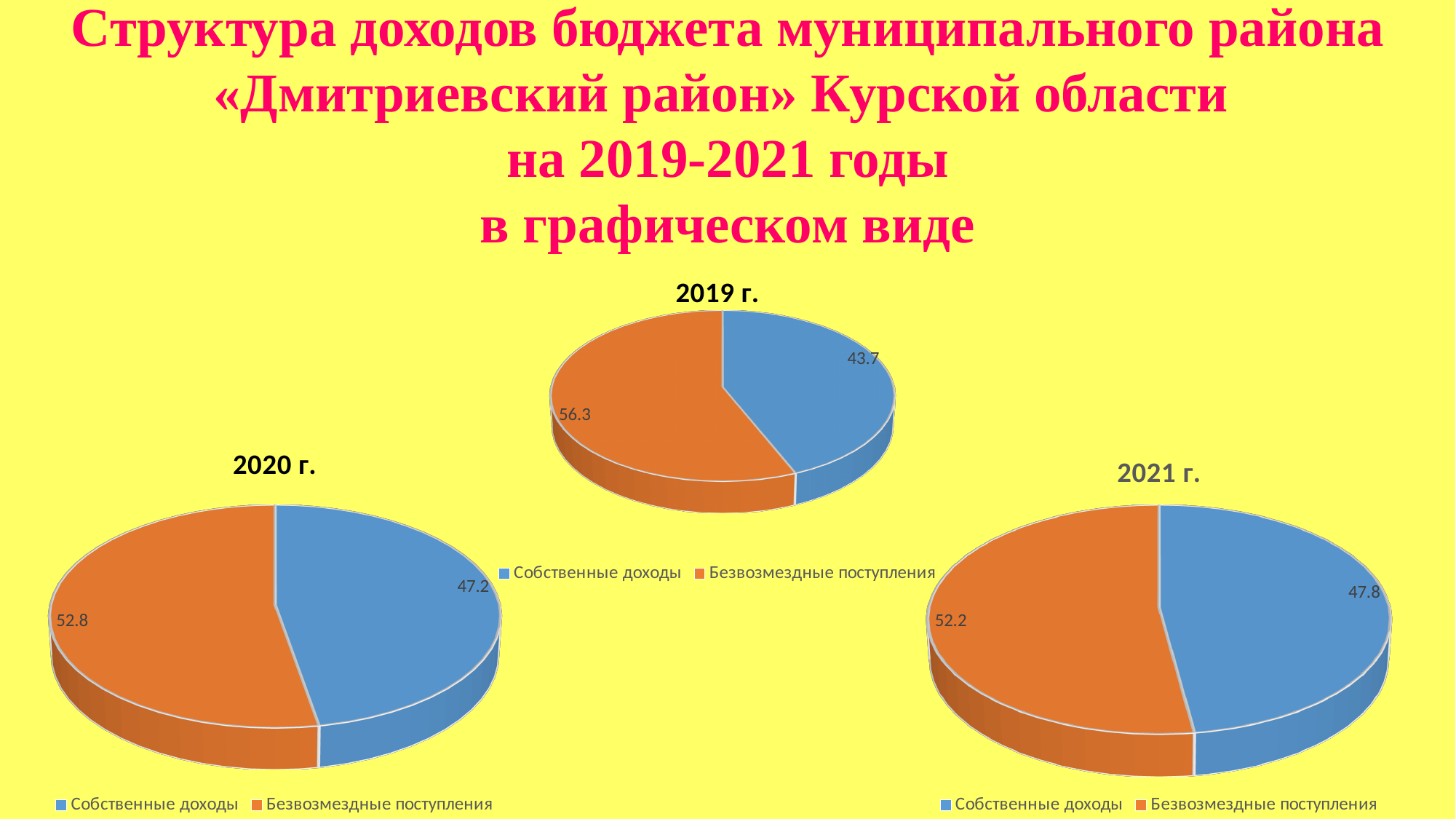
How many entries does the legend of the chart titled "2021 г." list? 2 In the chart titled "2020 г.", what is the difference between the values for Безвозмездные поступления and Собственные доходы? 5.6 In the chart titled "2019 г.", what is the value for Безвозмездные поступления? 56.3 In the chart titled "2021 г.", what is the value for Собственные доходы? 47.8 In the chart titled "2021 г.", what is the value for Безвозмездные поступления? 52.2 In the chart titled "2019 г.", which category has the larger share? Безвозмездные поступления In the chart titled "2019 г.", what is the value for Собственные доходы? 43.7 In the chart titled "2021 г.", which category has the smaller share? Собственные доходы How many slices does the chart titled "2020 г." have? 2 In the chart titled "2020 г.", what is the value for Безвозмездные поступления? 52.8 In the chart titled "2020 г.", what is the value for Собственные доходы? 47.2 What kind of chart is the chart titled "2019 г."? Pie chart